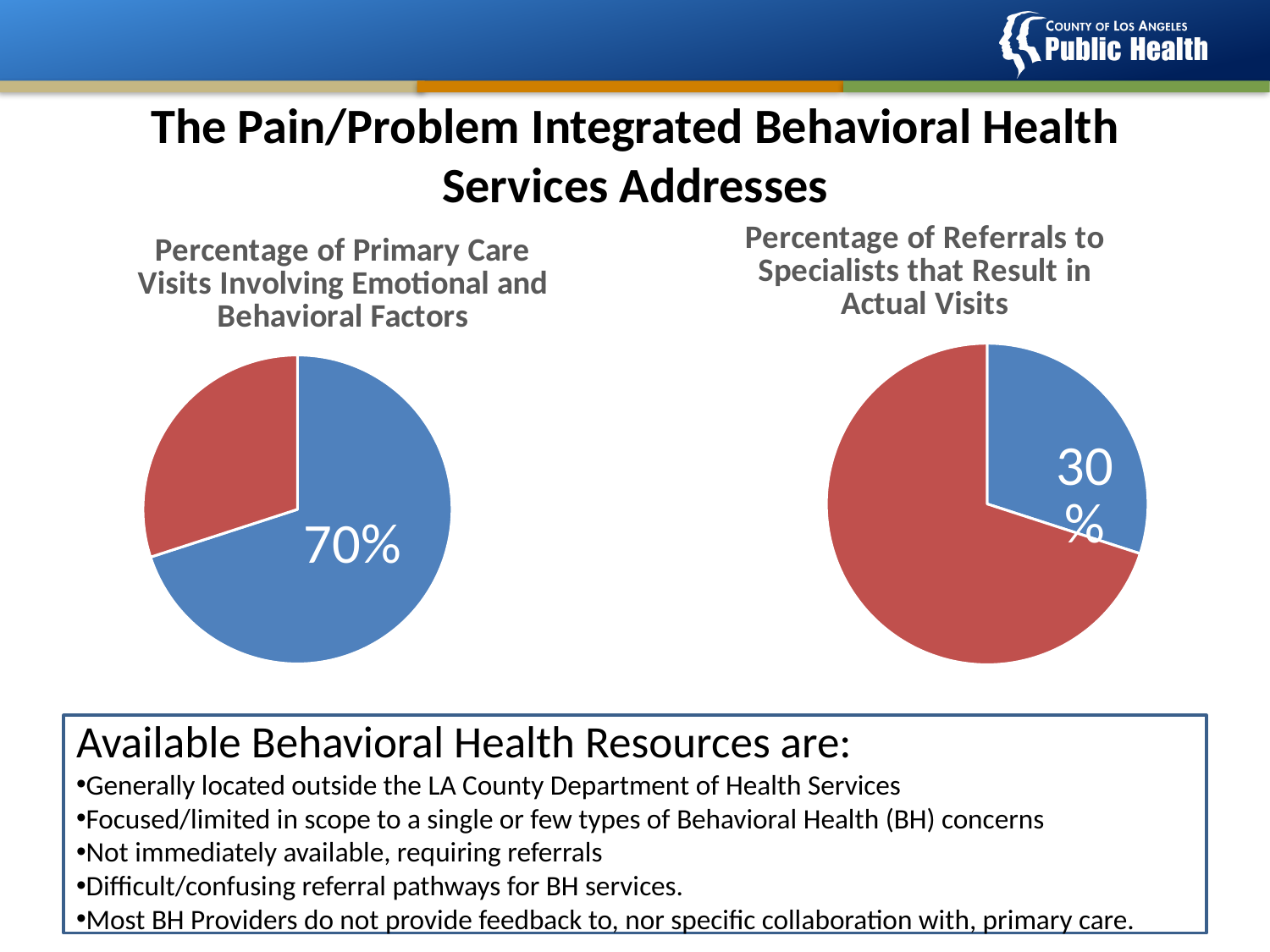
In the right chart, 'Percentage of Referrals to Specialists that Result in Actual Visits', what value is printed on the blue slice? 30% How many slices does the right chart, 'Percentage of Referrals to Specialists that Result in Actual Visits', have? 2 What is the difference between the labeled blue slice in the left chart (70%) and the labeled blue slice in the right chart (30%)? 40 percentage points In the left chart, 'Percentage of Primary Care Visits Involving Emotional and Behavioral Factors', what value is printed on the blue slice? 70% In the left chart, 'Percentage of Primary Care Visits Involving Emotional and Behavioral Factors', which slice is larger, the blue one or the red one? Blue What kind of chart is the right chart, 'Percentage of Referrals to Specialists that Result in Actual Visits'? Pie chart What kind of chart is the left chart, 'Percentage of Primary Care Visits Involving Emotional and Behavioral Factors'? Pie chart What is the title of the pie chart on the right side of the slide? Percentage of Referrals to Specialists that Result in Actual Visits What colour is the slice labeled 70% in the left chart? Blue What share of the pie does the blue slice represent in the left chart, 'Percentage of Primary Care Visits Involving Emotional and Behavioral Factors'? 70% How many slices does the left chart, 'Percentage of Primary Care Visits Involving Emotional and Behavioral Factors', have? 2 In the right chart, 'Percentage of Referrals to Specialists that Result in Actual Visits', which slice is larger, the blue one or the red one? Red